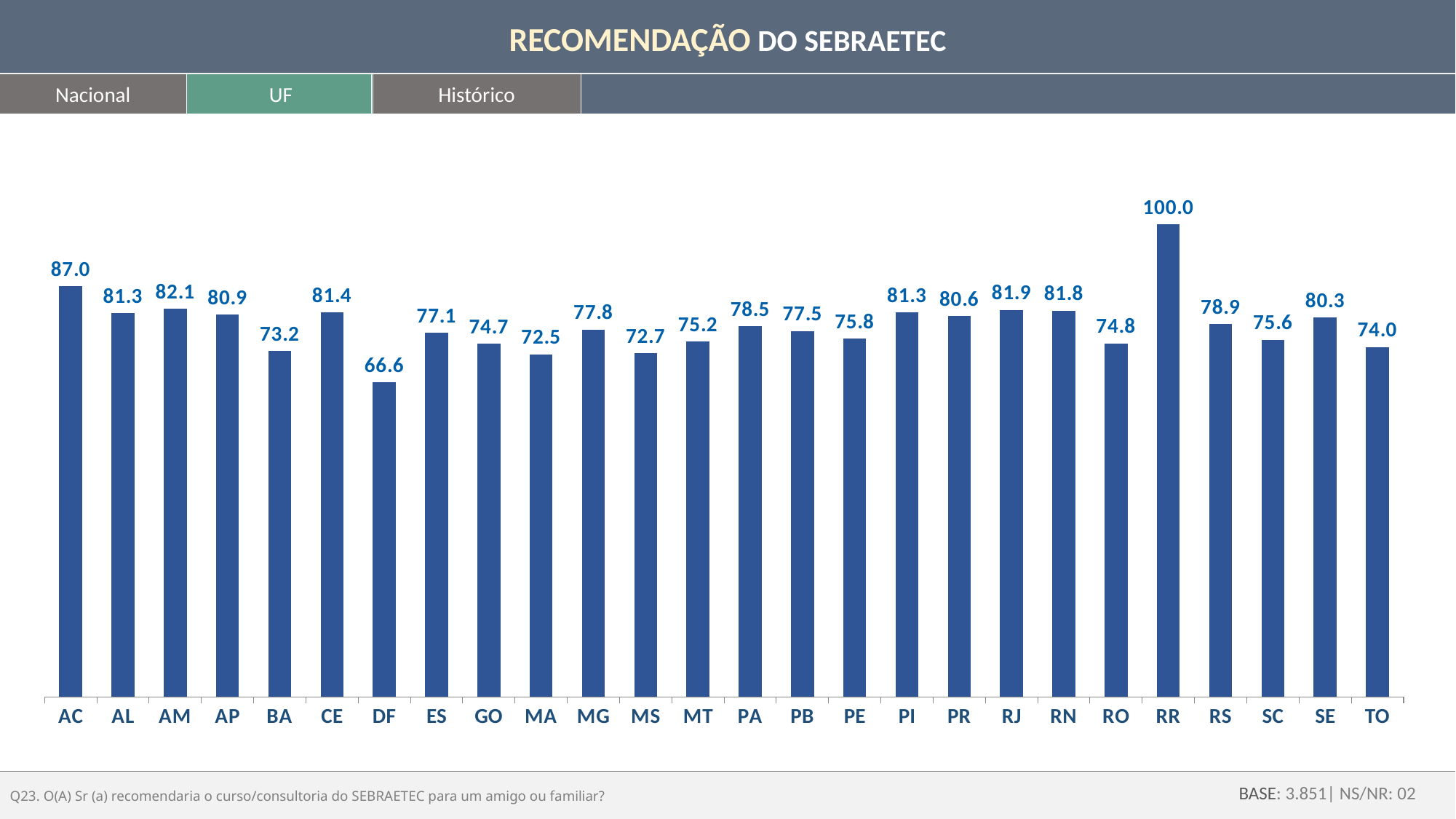
What is the difference between the values for RR and DF? 33.4 What is the value for DF? 66.6 What is the value for SE? 80.3 What is the difference between the values for AC and AL? 5.7 Which has a larger value, AC or AM? AC What kind of chart is shown on the slide? Bar chart What is the value for RR? 100.0 Which state has the lowest value? DF How many states (categories) are shown on the x axis? 26 What is the value for MG? 77.8 Which state has the highest value? RR Which has a larger value, BA or PA? PA